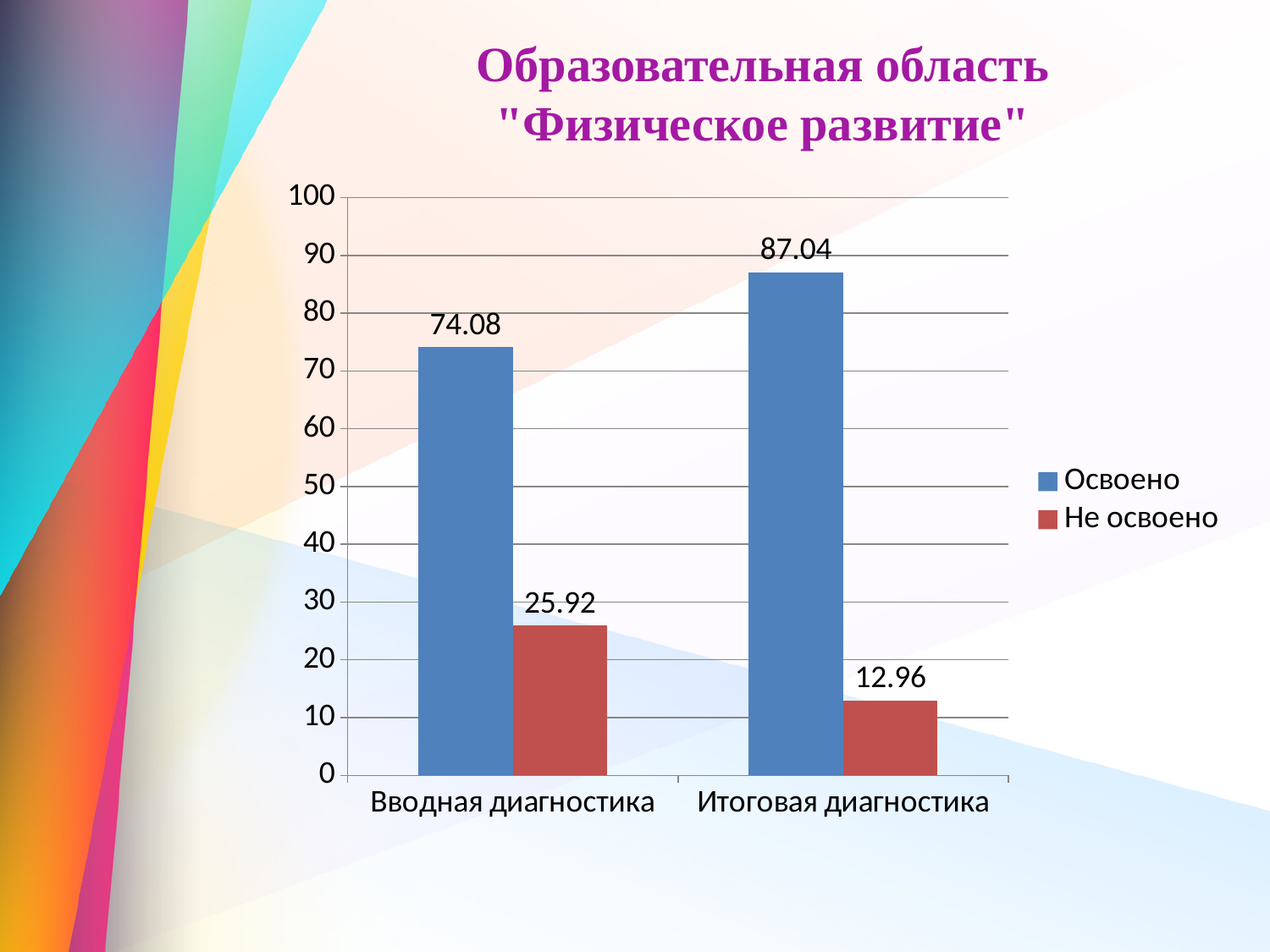
What kind of chart is shown on the slide? bar chart How many categories are shown on the x axis? 2 Which is larger: "Не освоено" for "Вводная диагностика" or "Не освоено" for "Итоговая диагностика"? Вводная диагностика Which category has the lowest value for "Не освоено"? Итоговая диагностика What is the value of "Не освоено" for "Итоговая диагностика"? 12.96 What is the value of "Освоено" for "Вводная диагностика"? 74.08 What is the difference between the "Освоено" values for "Итоговая диагностика" and "Вводная диагностика"? 12.96 Which category has the highest value for "Освоено"? Итоговая диагностика What is the value of "Не освоено" for "Вводная диагностика"? 25.92 How many series does the legend list? 2 Does the "Освоено" series rise or fall from "Вводная диагностика" to "Итоговая диагностика"? rise Is the value of "Освоено" for "Итоговая диагностика" greater or less than 80? greater